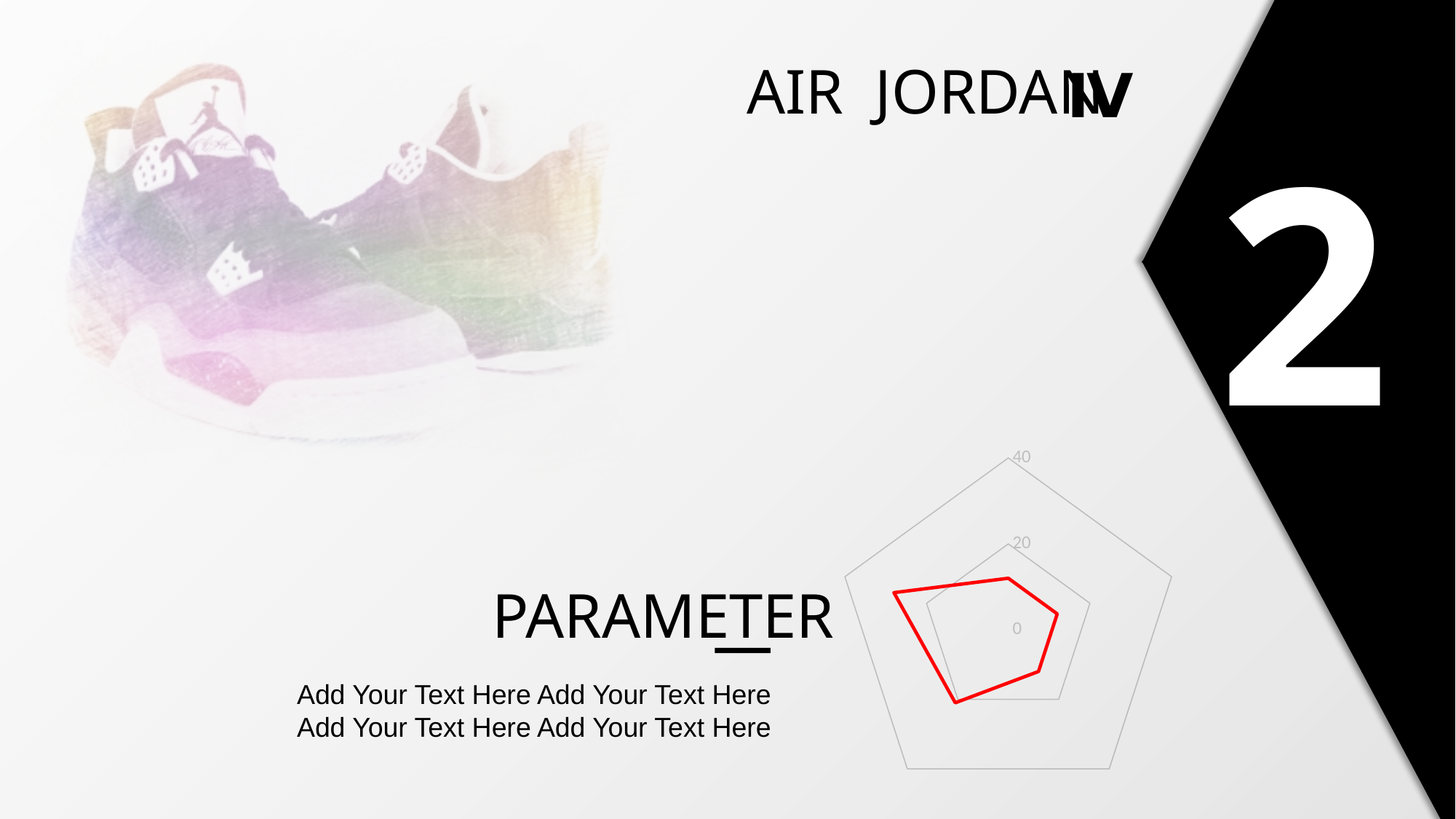
What colour is the plotted data line on the radar chart? red Is the value on the left-hand axis of the radar chart greater or less than 20? greater What is the highest value labelled on the radar chart's scale? 40 How many axes (categories) does the radar chart have? 5 Is the value on the right-hand axis of the radar chart greater or less than 20? less Which axis of the radar chart has the larger value, the left-hand axis or the right-hand axis? left-hand axis What kind of chart is shown on the slide? radar chart How many data series are plotted on the radar chart? 1 Is the value on the left-hand axis of the radar chart greater or less than 40? less